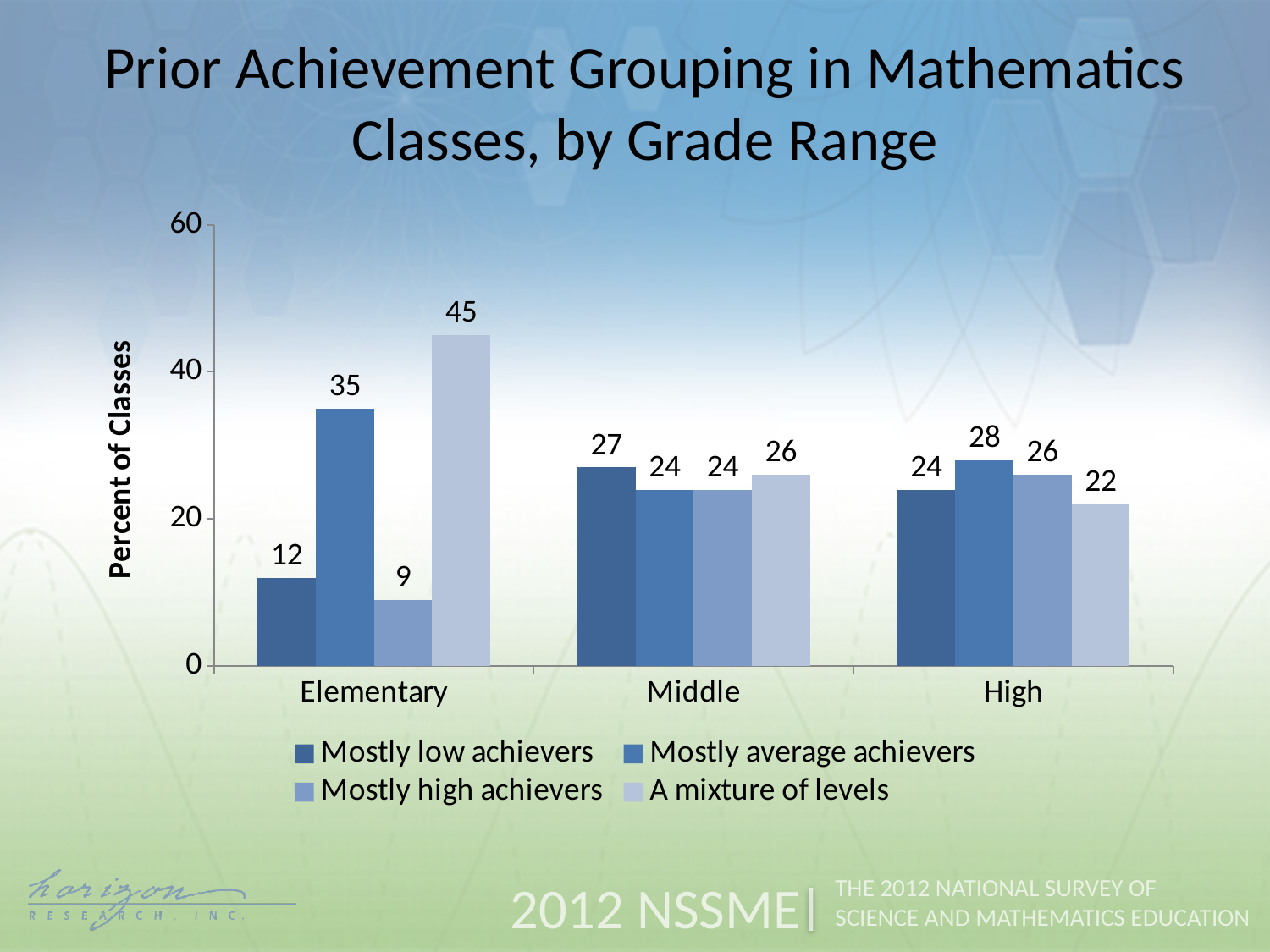
How many grade ranges are shown on the x axis? 3 What is the value for Mostly average achievers in the High grade range? 28 Which series has the lowest value in the High grade range? A mixture of levels How many series does the legend list? 4 What is the value for Mostly low achievers in the Middle grade range? 27 What is the difference between the Mostly average achievers and Mostly low achievers values for Elementary? 23 Is the value for A mixture of levels in the Elementary grade range greater or less than 40? greater What kind of chart is shown on the slide? Bar chart What percent of Elementary classes are grouped as a mixture of levels? 45 Which series has the highest value in the Elementary grade range? A mixture of levels What is the value for Mostly high achievers in the Elementary grade range? 9 Which is larger for the Middle grade range: Mostly low achievers or A mixture of levels? Mostly low achievers